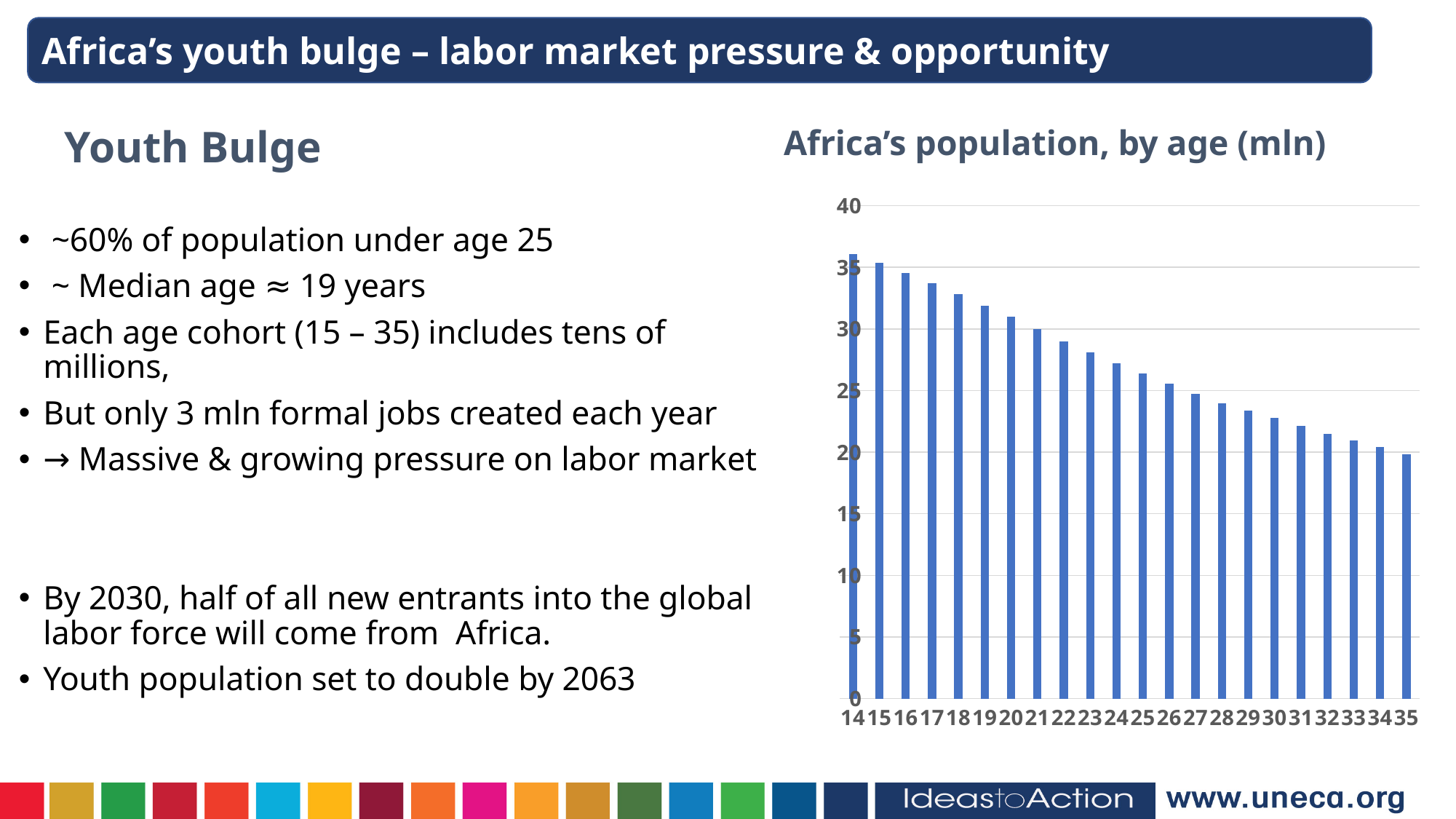
Which age has the highest population in the chart? 14 Is the value for age 14 greater or less than 30? greater Is the value for age 30 greater or less than 25? less How many age categories are plotted on the x axis of the chart? 22 Is the value for age 35 greater or less than 25? less Which age has the lowest population in the chart? 35 Which is larger, the value for age 20 or the value for age 30? age 20 What is the title of the chart on the slide? Africa's population, by age (mln) What kind of chart is shown under the title "Africa's population, by age (mln)"? bar chart Do the values rise or fall as age increases from 14 to 35? fall Which is larger, the value for age 16 or the value for age 25? age 16